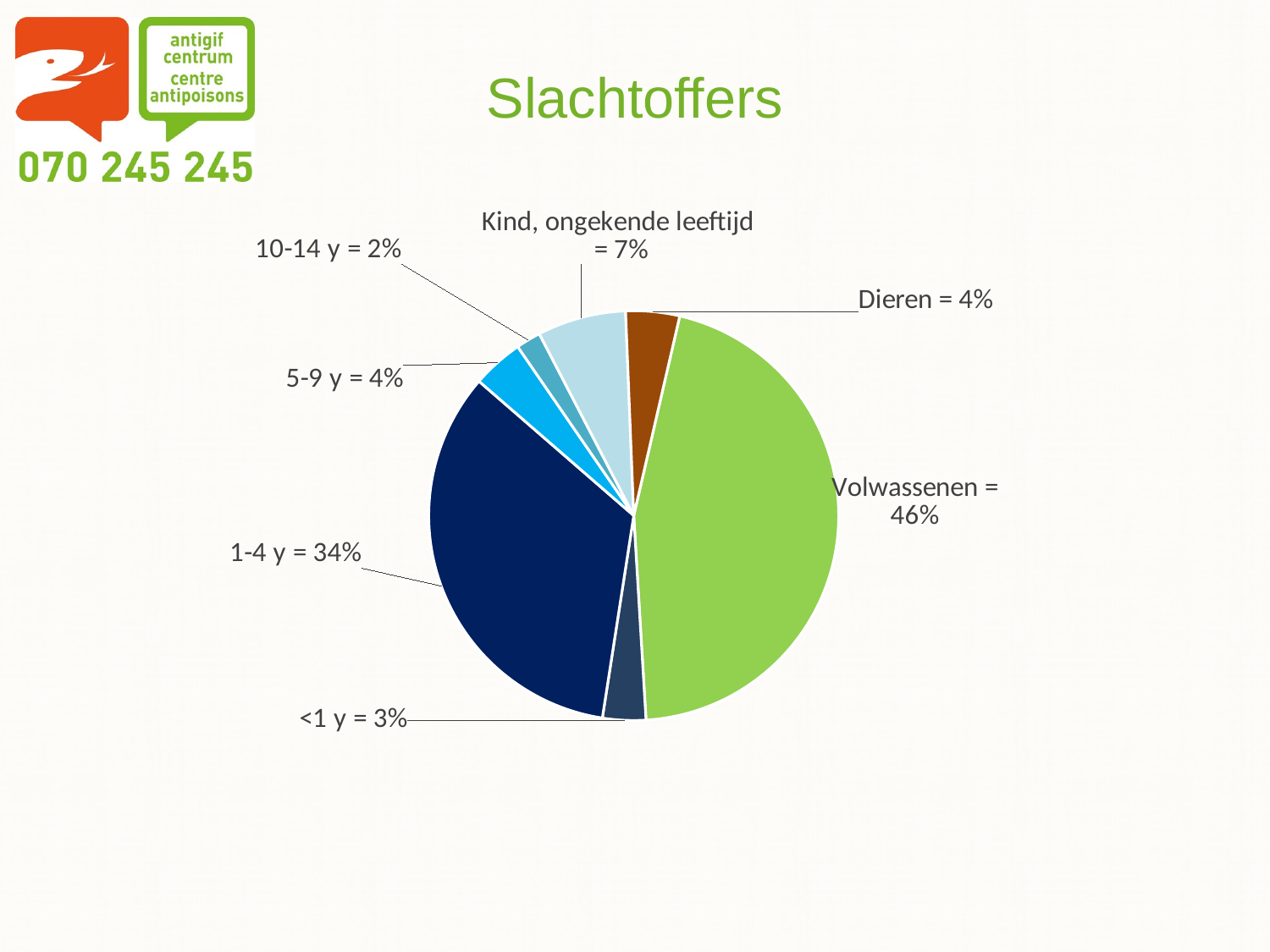
What is the value for Kind, ongekende leeftijd? 7% What is the value for Dieren? 4% Which category has the largest slice of the pie? Volwassenen What kind of chart is shown on the slide? pie chart Which category has the smallest slice of the pie? 10-14 y What is the difference between the Volwassenen share and the 1-4 y share? 12% What is the title of the slide? Slachtoffers What share of the pie is Volwassenen? 46% Which is larger, the share for 5-9 y or the share for 10-14 y? 5-9 y What share of the pie is 1-4 y? 34% What is the value for <1 y? 3% How many slices does the pie chart have? 7